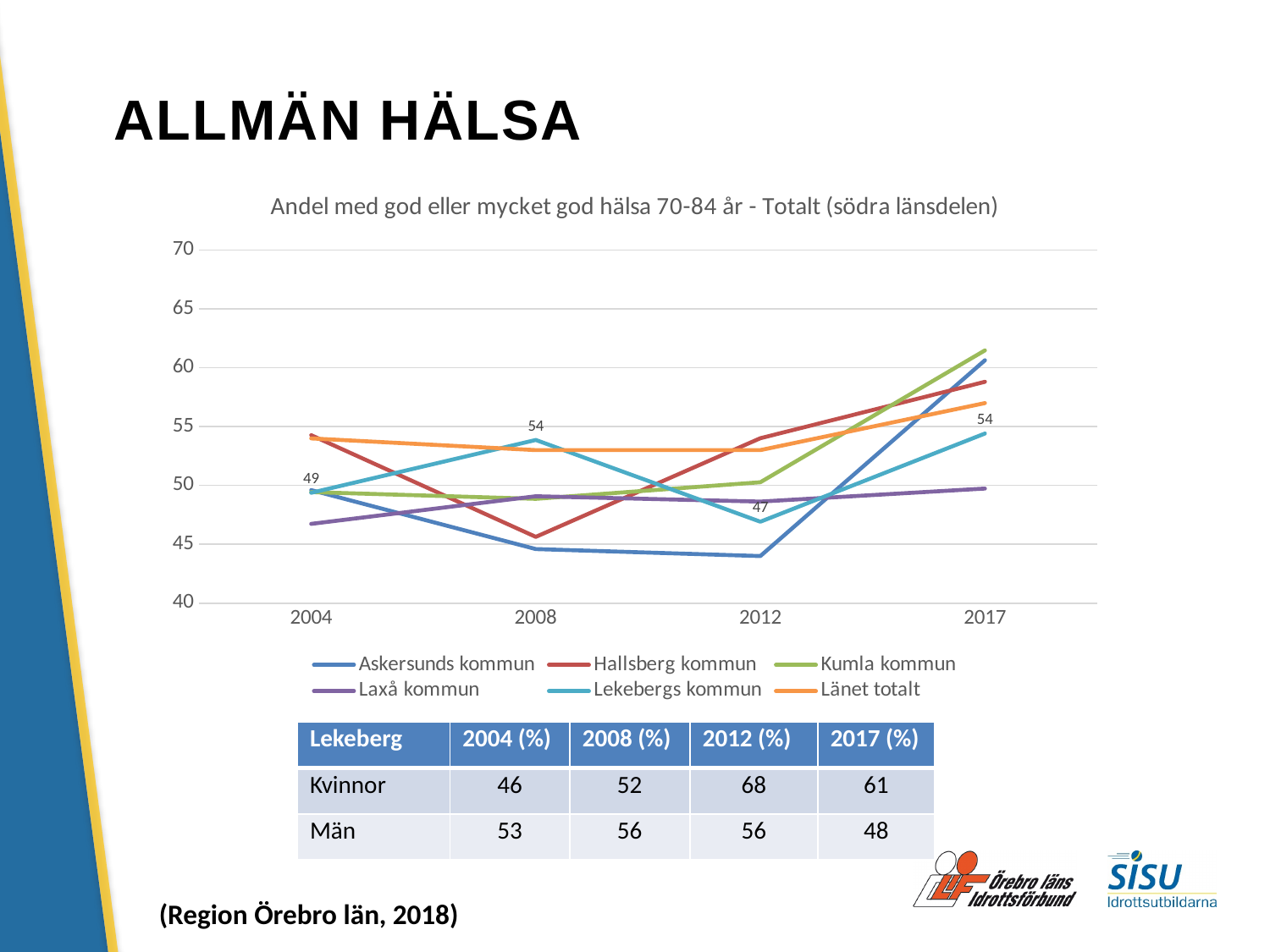
Which series has the lowest value in 2012? Askersunds kommun What type of chart is shown on the slide? line chart What is the labelled value for Lekebergs kommun in 2012? 47 What is the difference between the Lekebergs kommun values for 2008 and 2012? 7 Which is larger for Lekebergs kommun, the 2004 value or the 2012 value? 2004 What is the labelled value for Lekebergs kommun in 2004? 49 Is the value for Kumla kommun in 2017 greater or less than 60? greater How many years are shown on the x axis of the chart? 4 How many series does the chart legend list? 6 Is the value for Askersunds kommun in 2012 greater or less than 45? less What is the title of the chart? Andel med god eller mycket god hälsa 70-84 år - Totalt (södra länsdelen) What is the labelled value for Lekebergs kommun in 2008? 54